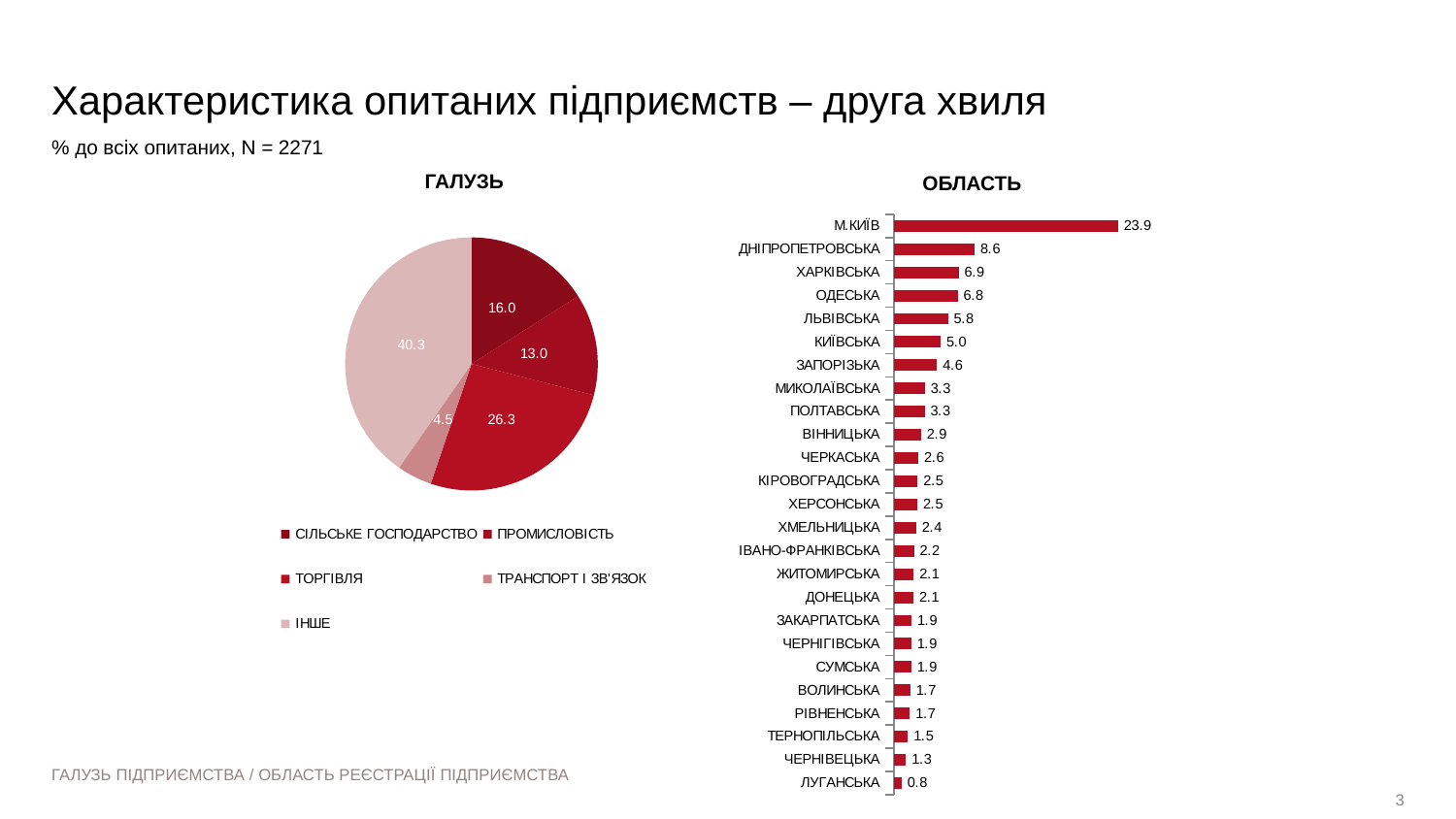
In the ОБЛАСТЬ chart, what is the difference between the values for ДНІПРОПЕТРОВСЬКА and ХАРКІВСЬКА? 1.7 How many categories does the legend of the ГАЛУЗЬ pie chart list? 5 In the ОБЛАСТЬ chart, which region has the highest value? М.КИЇВ In the ГАЛУЗЬ pie chart, which category has the largest slice? ІНШЕ How many regions are shown in the ОБЛАСТЬ chart? 25 What kind of chart is the ОБЛАСТЬ chart? Bar chart In the ОБЛАСТЬ chart, what is the value for ЛЬВІВСЬКА? 5.8 In the ГАЛУЗЬ pie chart, what is the value for ТОРГІВЛЯ? 26.3 In the ГАЛУЗЬ pie chart, what is the difference between the values for СІЛЬСЬКЕ ГОСПОДАРСТВО and ПРОМИСЛОВІСТЬ? 3.0 In the ОБЛАСТЬ chart, which region has the lowest value? ЛУГАНСЬКА In the ОБЛАСТЬ chart, which is larger, the value for ЗАПОРІЗЬКА or the value for КИЇВСЬКА? КИЇВСЬКА In the ОБЛАСТЬ chart, what is the value for М.КИЇВ? 23.9